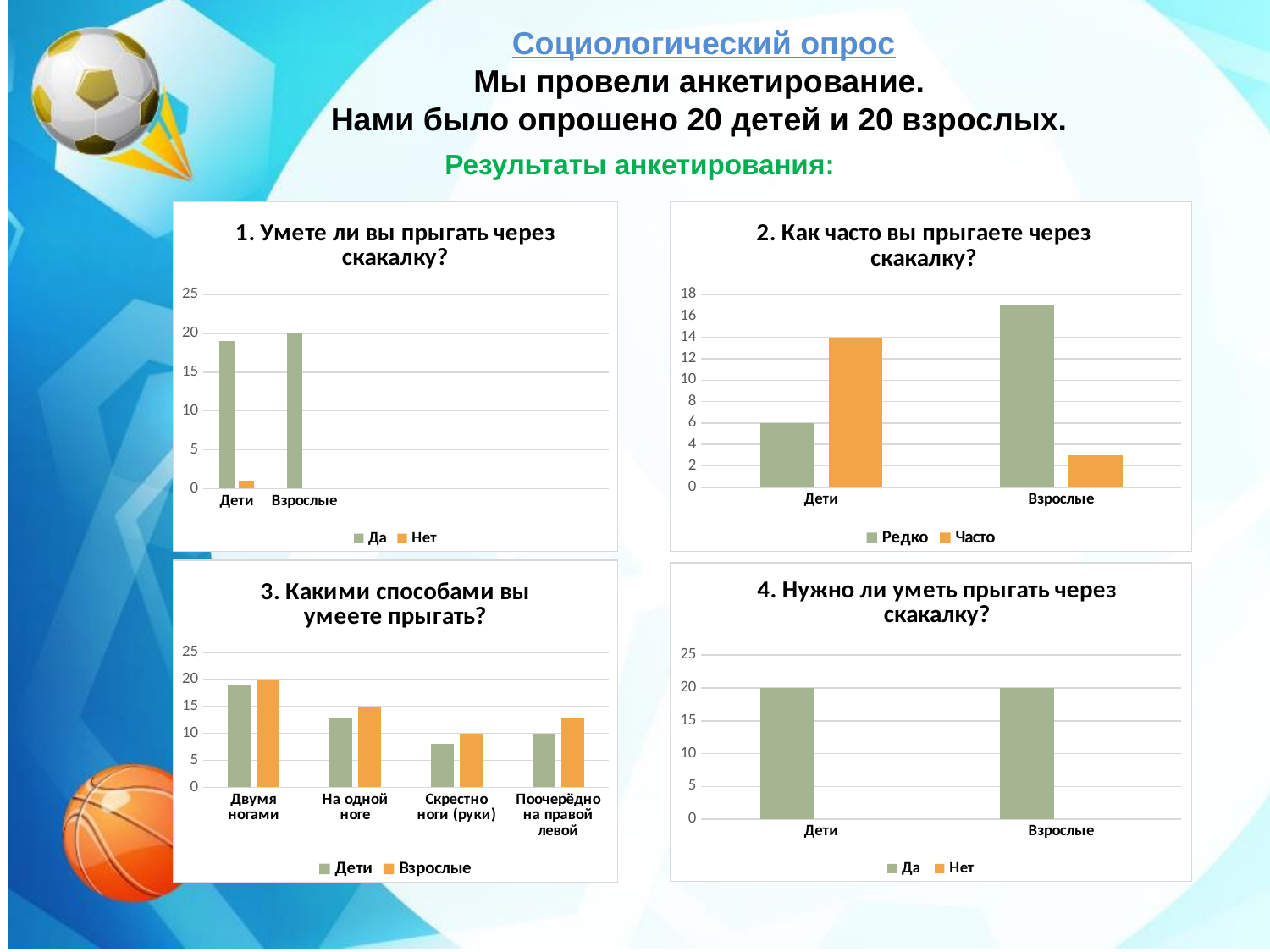
In the chart titled "4. Нужно ли уметь прыгать через скакалку?", what is the value for Дети in the Да series? 20 In the chart titled "2. Как часто вы прыгаете через скакалку?", is the Редко value for Взрослые greater or less than 16? greater In the chart titled "1. Умете ли вы прыгать через скакалку?", what is the value for Взрослые in the Да series? 20 In the chart titled "2. Как часто вы прыгаете через скакалку?", which series does the legend list besides Редко? Часто In the chart titled "3. Какими способами вы умеете прыгать?", how many categories are shown on the x axis? 4 In the chart titled "2. Как часто вы прыгаете через скакалку?", what is the value for Дети in the Часто series? 14 In the chart titled "1. Умете ли вы прыгать через скакалку?", is the Нет value for Дети greater or less than 5? less In the chart titled "3. Какими способами вы умеете прыгать?", which category has the lowest value for Дети? Скрестно ноги (руки) What kind of chart is the one titled "4. Нужно ли уметь прыгать через скакалку?"? bar chart In the chart titled "2. Как часто вы прыгаете через скакалку?", what is the value for Дети in the Редко series? 6 In the chart titled "3. Какими способами вы умеете прыгать?", what is the value for Взрослые in the category На одной ноге? 15 In the chart titled "2. Как часто вы прыгаете через скакалку?", what is the difference between the Часто and Редко values for Дети? 8